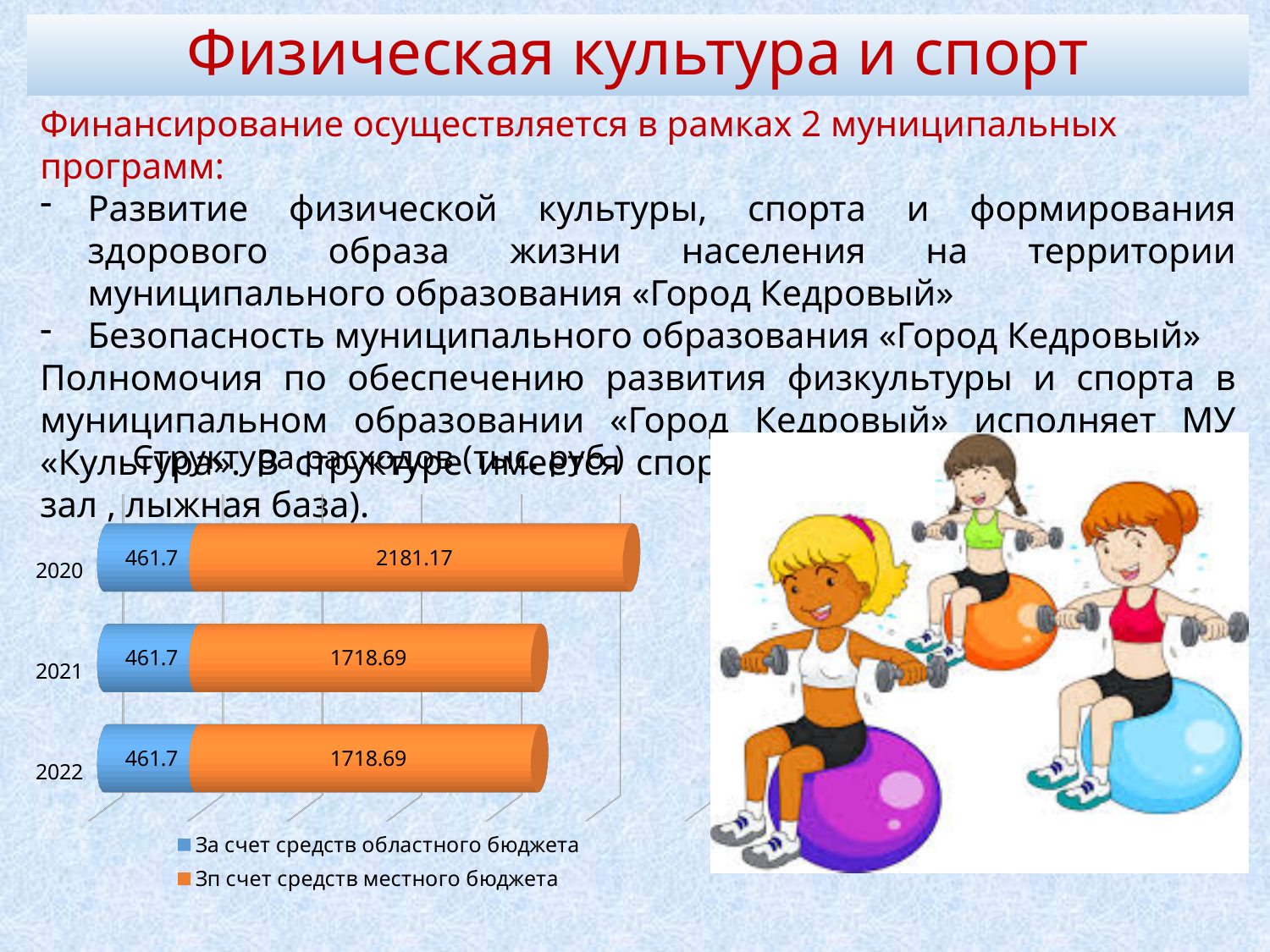
Which is larger in 2020: the 'За счет средств областного бюджета' value or the 'Зп счет средств местного бюджета' value? Зп счет средств местного бюджета What is the total of the stacked bar for 2020? 2642.87 What is the value for 'За счет средств областного бюджета' in 2021? 461.7 What is the total of the stacked bar for 2021? 2180.39 Which year has the highest value for 'Зп счет средств местного бюджета'? 2020 What kind of chart is shown on the slide? Stacked bar chart What is the difference between the 'Зп счет средств местного бюджета' values for 2020 and 2021? 462.48 What is the value for 'Зп счет средств местного бюджета' in 2022? 1718.69 How many series does the legend list? 2 What is the value for 'Зп счет средств местного бюджета' in 2020? 2181.17 How many years (categories) are shown in the chart? 3 Which colour represents 'За счет средств областного бюджета' in the chart? Blue